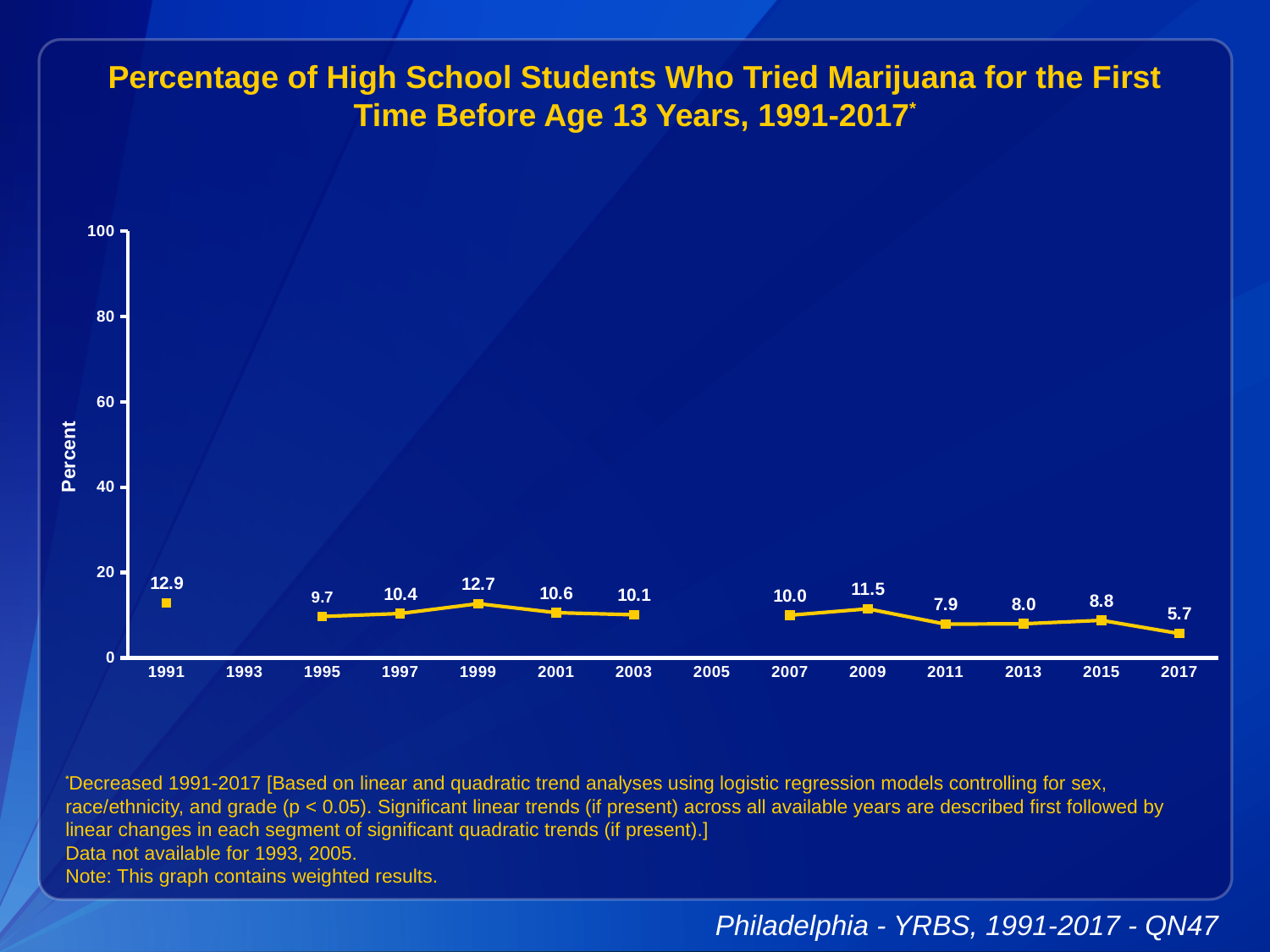
Do the values generally rise or fall from 1991 to 2017? fall What is the difference between the values for 1991 and 2017? 7.2 How many years have data points plotted on the chart? 12 Which year has the lowest value? 2017 Is the value for 2003 greater or less than 20? less What is the label on the y axis? Percent Which year has the highest value? 1991 What is the value for 1991? 12.9 What kind of chart is this? line chart Which is larger, the value for 1999 or the value for 2011? 1999 What is the value for 2009? 11.5 What is the value for 2017? 5.7